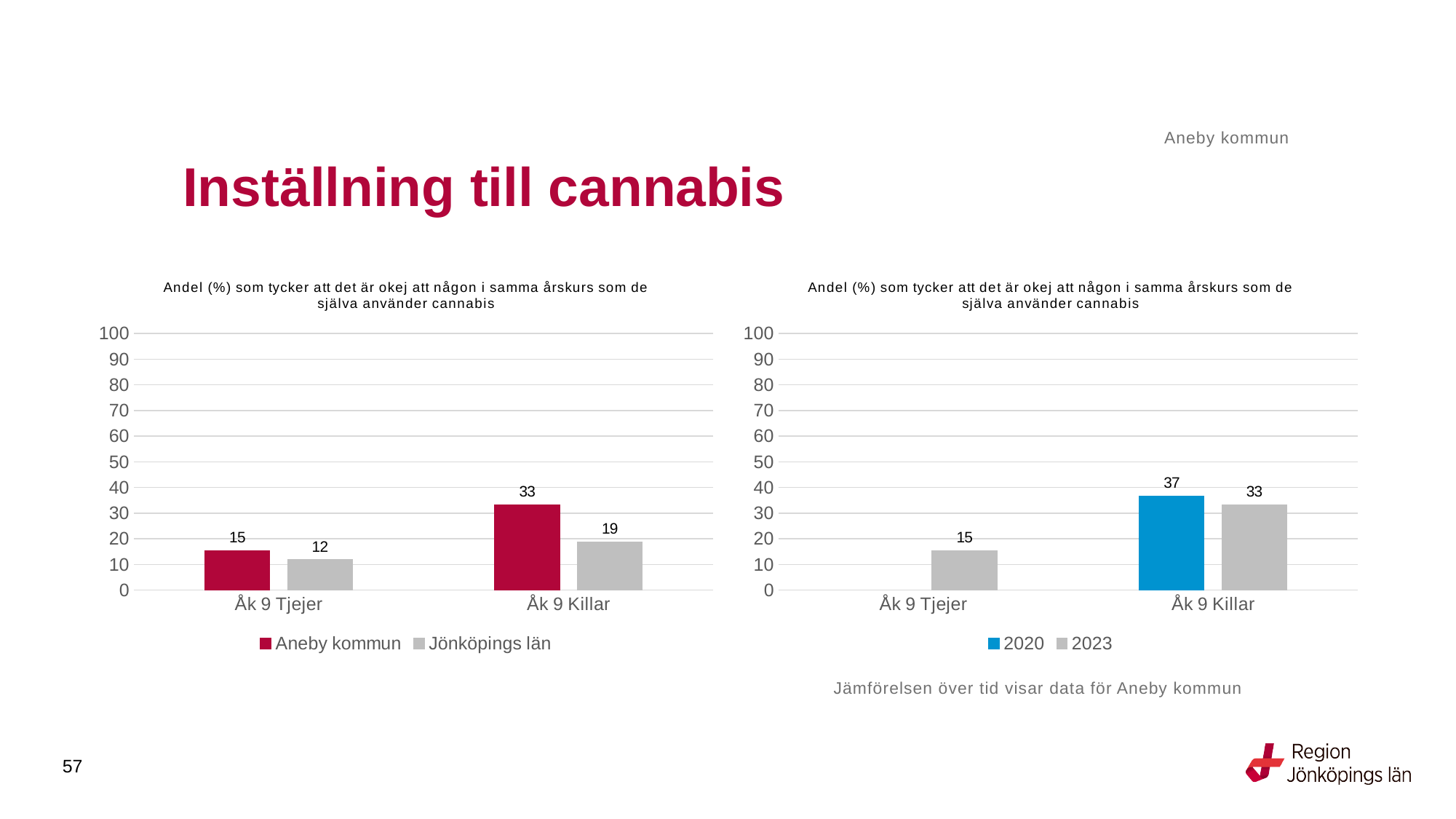
In the right chart, what is the difference between 2020 and 2023 for Åk 9 Killar? 4 In the left chart, what is the difference between Aneby kommun and Jönköpings län for Åk 9 Killar? 14 In the left chart, what is the value for Jönköpings län for Åk 9 Tjejer? 12 In the right chart, which year has the higher value for Åk 9 Killar? 2020 In the right chart, what are the two legend entries? 2020 and 2023 In the right chart, how many categories are shown on the x axis? 2 In the left chart, what is the value for Aneby kommun for Åk 9 Killar? 33 In the right chart, what is the value for 2020 for Åk 9 Killar? 37 In the left chart, which is larger for Åk 9 Tjejer: Aneby kommun or Jönköpings län? Aneby kommun In the right chart, what is the value for 2023 for Åk 9 Tjejer? 15 In the left chart, how many series does the legend list? 2 In the left chart, what kind of chart is shown? Bar chart